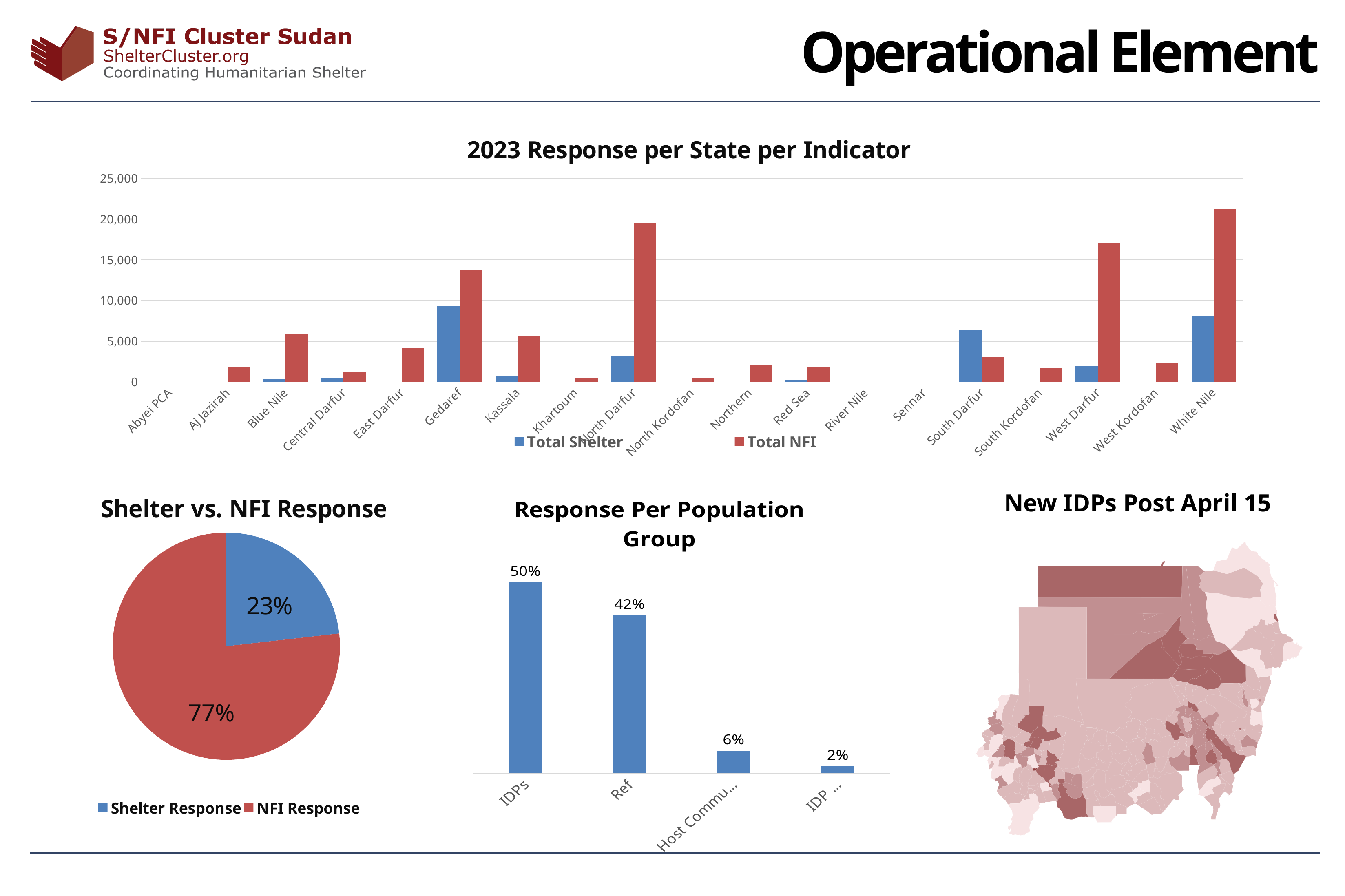
How many states are shown on the x axis of '2023 Response per State per Indicator'? 19 In '2023 Response per State per Indicator', is the Total NFI value for West Darfur greater or less than 15,000? greater In 'Response Per Population Group', what is the difference between the IDPs value and the Ref value? 8% In 'Response Per Population Group', what is the value for Ref? 42% What type of chart is '2023 Response per State per Indicator'? bar chart In '2023 Response per State per Indicator', which state has the highest Total Shelter value? Gedaref How many series does the legend of '2023 Response per State per Indicator' list? 2 In the 'Shelter vs. NFI Response' pie chart, which is larger, Shelter Response or NFI Response? NFI Response In '2023 Response per State per Indicator', is the Total NFI value for White Nile greater or less than 20,000? greater In '2023 Response per State per Indicator', is the Total Shelter value for Gedaref greater or less than 10,000? less In the 'Shelter vs. NFI Response' pie chart, what share is NFI Response? 77% In '2023 Response per State per Indicator', which state has the highest Total NFI value? White Nile